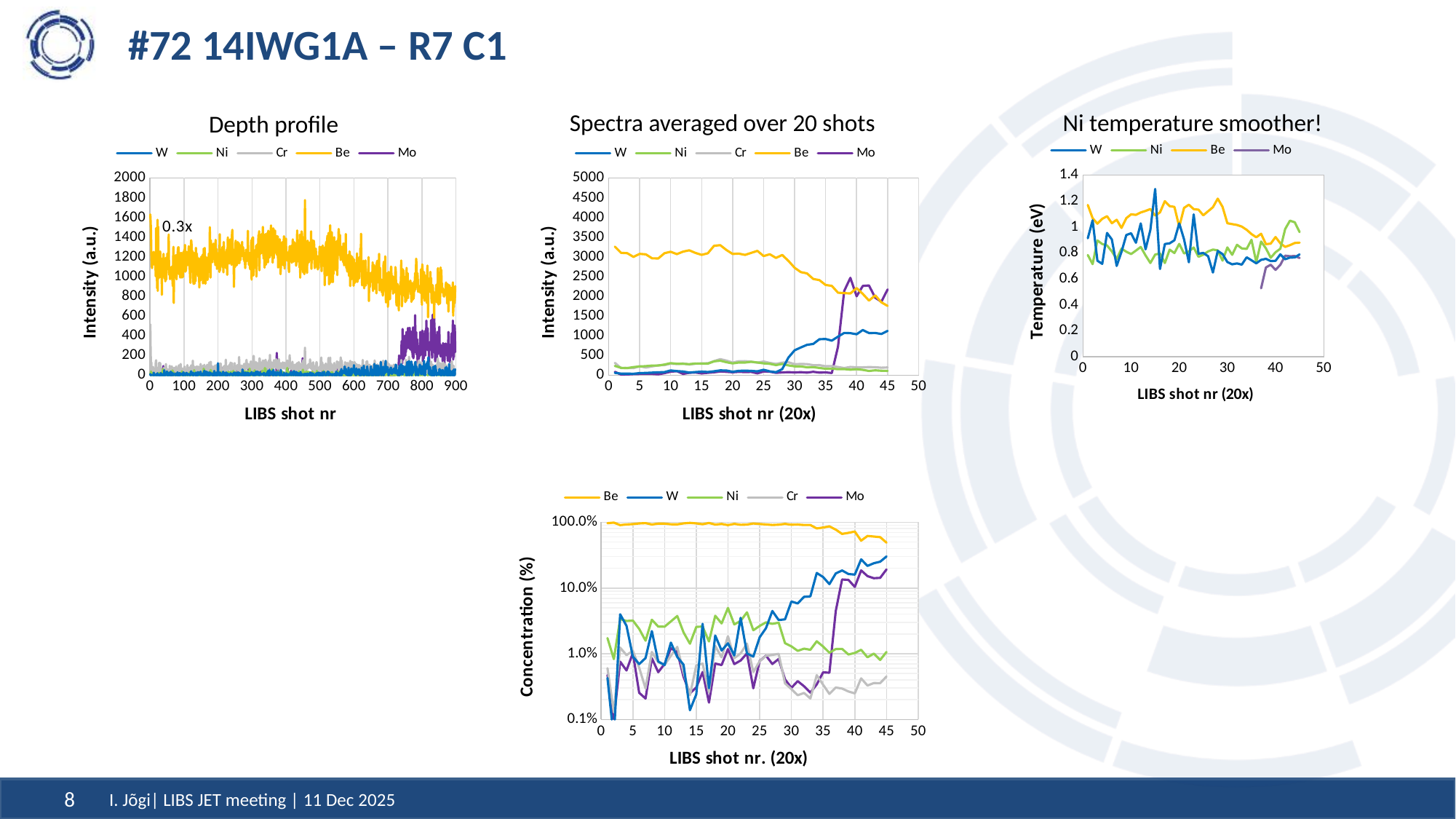
What kind of chart is the "Depth profile" chart? line chart In the "Spectra averaged over 20 shots" chart, does the W intensity rise or fall along the x axis? rise What is the y-axis label of the "Ni temperature smoother!" chart? Temperature (eV) What is the x-axis label of the "Depth profile" chart? LIBS shot nr In the "Spectra averaged over 20 shots" chart, does the Be intensity rise or fall along the x axis? fall In the "Depth profile" chart, is the Mo intensity at LIBS shot nr 800 greater or less than 1000? less How many series does the legend of the "Depth profile" chart list? 5 How many series does the legend of the "Ni temperature smoother!" chart list? 4 In the "Spectra averaged over 20 shots" chart, which series has the larger intensity at LIBS shot nr 45, W or Ni? W In the "Spectra averaged over 20 shots" chart, is the Be intensity at LIBS shot nr 5 greater or less than 2000? greater In the "Depth profile" chart, is the Be intensity at LIBS shot nr 400 greater or less than 600? greater